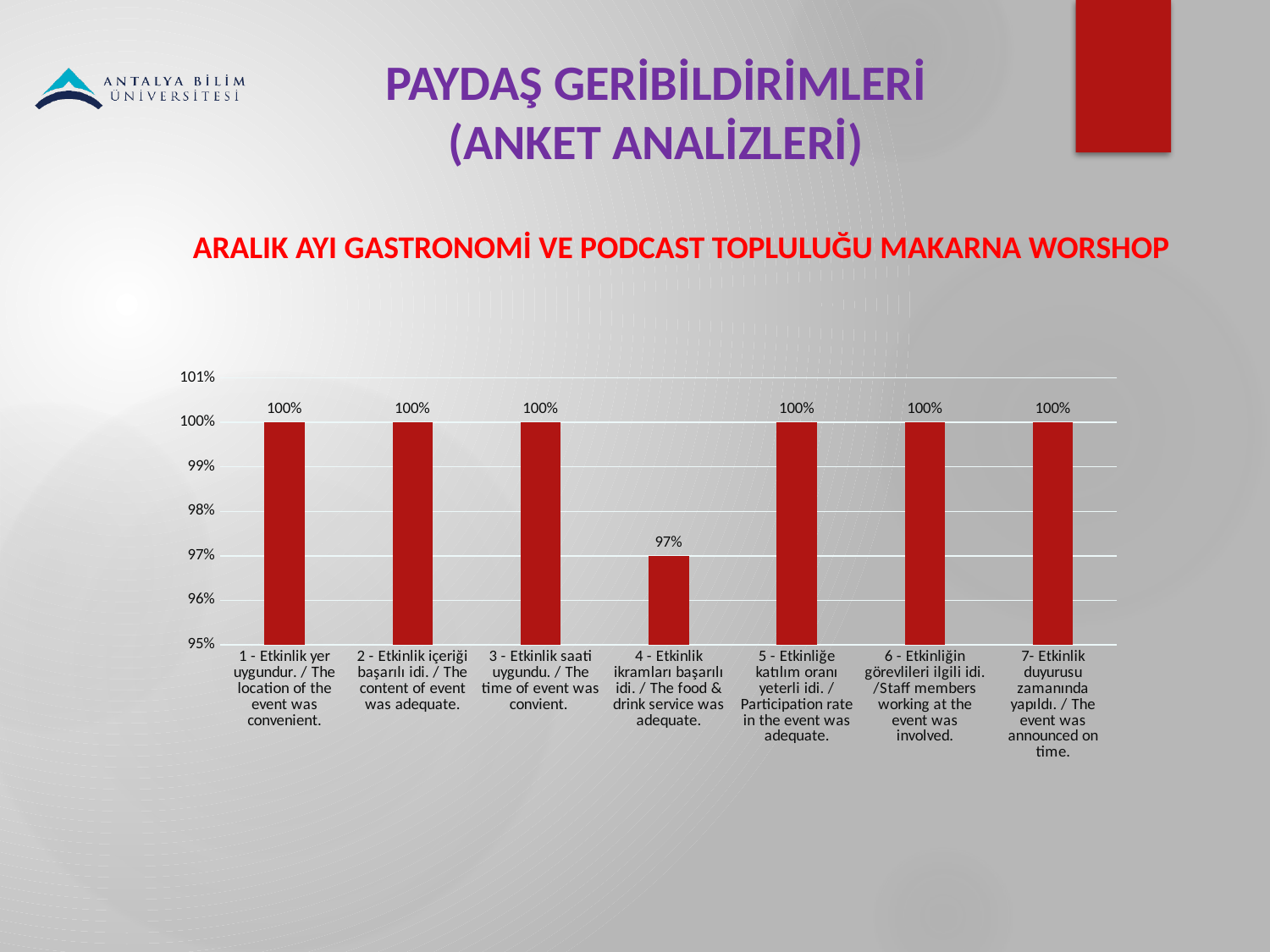
What colour are the bars in the chart? Red What is the value for item 4 (Etkinlik ikramları başarılı idi. / The food & drink service was adequate.)? 97% Is the value for item 4 (food & drink service) greater or less than 98%? less How many categories (survey items) are plotted in the chart? 7 Which survey item has the lowest value in the chart? 4 - Etkinlik ikramları başarılı idi. / The food & drink service was adequate. What is the value for item 6 (Etkinliğin görevlileri ilgili idi. / Staff members working at the event was involved.)? 100% What is the value for item 1 (Etkinlik yer uygundur. / The location of the event was convenient.)? 100% What is the value for item 7 (Etkinlik duyurusu zamanında yapıldı. / The event was announced on time.)? 100% What is the difference between the value for item 1 (location of the event) and item 4 (food & drink service)? 3% What kind of chart is shown on the slide? Bar chart How many survey items have a value of 100%? 6 Which is larger: the value for item 4 (food & drink service) or item 5 (participation rate)? Item 5 (participation rate)